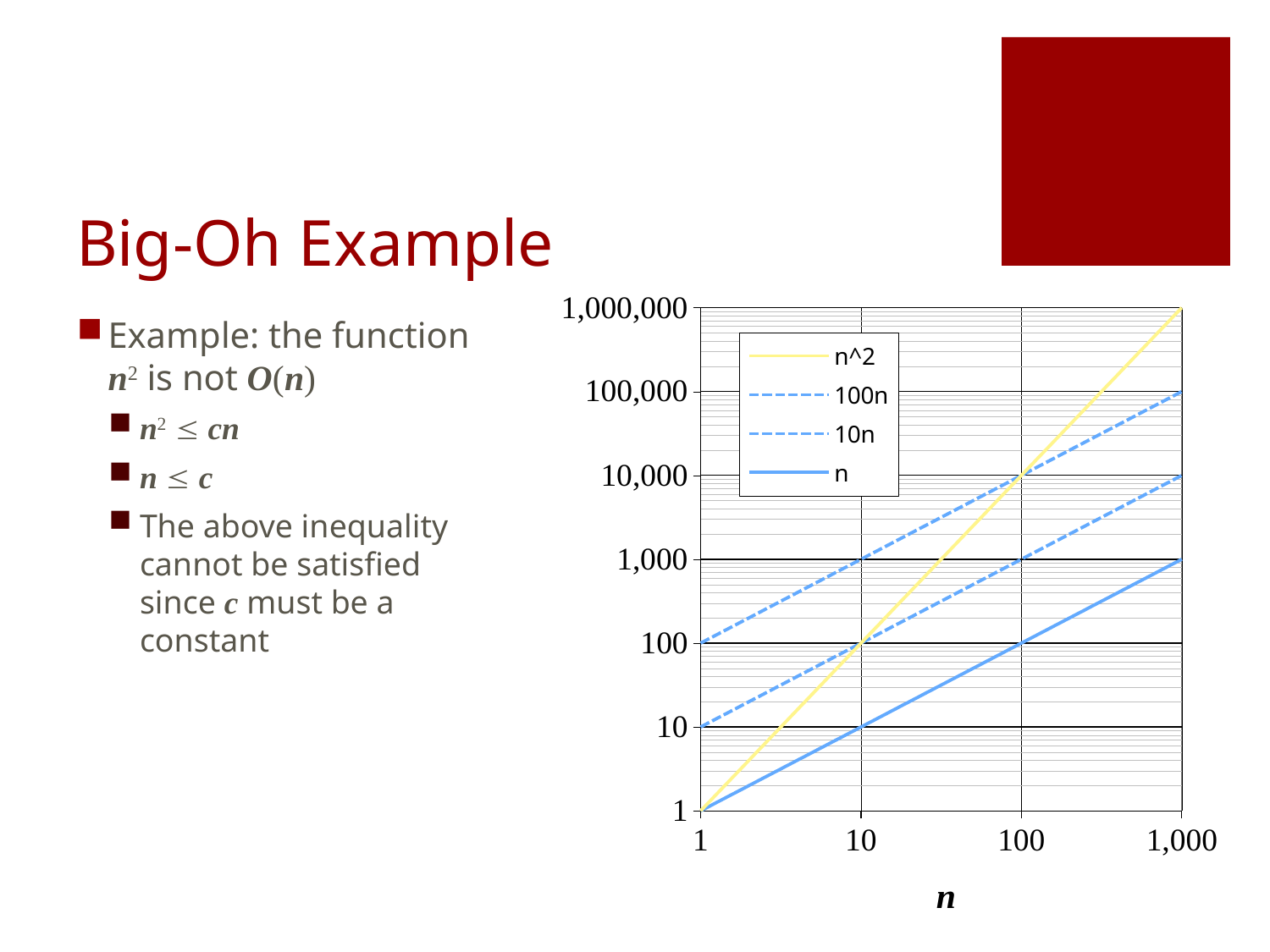
What is the value of the n series at n = 1,000? 1,000 Which series has the lowest value at n = 1,000? n What kind of chart is shown on the slide? line chart Which series has the highest value at n = 1,000? n^2 What is the label on the x axis of the chart? n At n = 10, which is larger: the 100n series or the n^2 series? 100n What is the value of the n^2 series at n = 1,000? 1,000,000 What is the value of the 100n series at n = 1,000? 100,000 Is the value of the 10n series at n = 1,000 greater or less than 1,000? greater How many series does the chart's legend list? 4 What is the value of the 10n series at n = 100? 1,000 Do the values of the n^2 series rise or fall as n increases along the x axis? rise